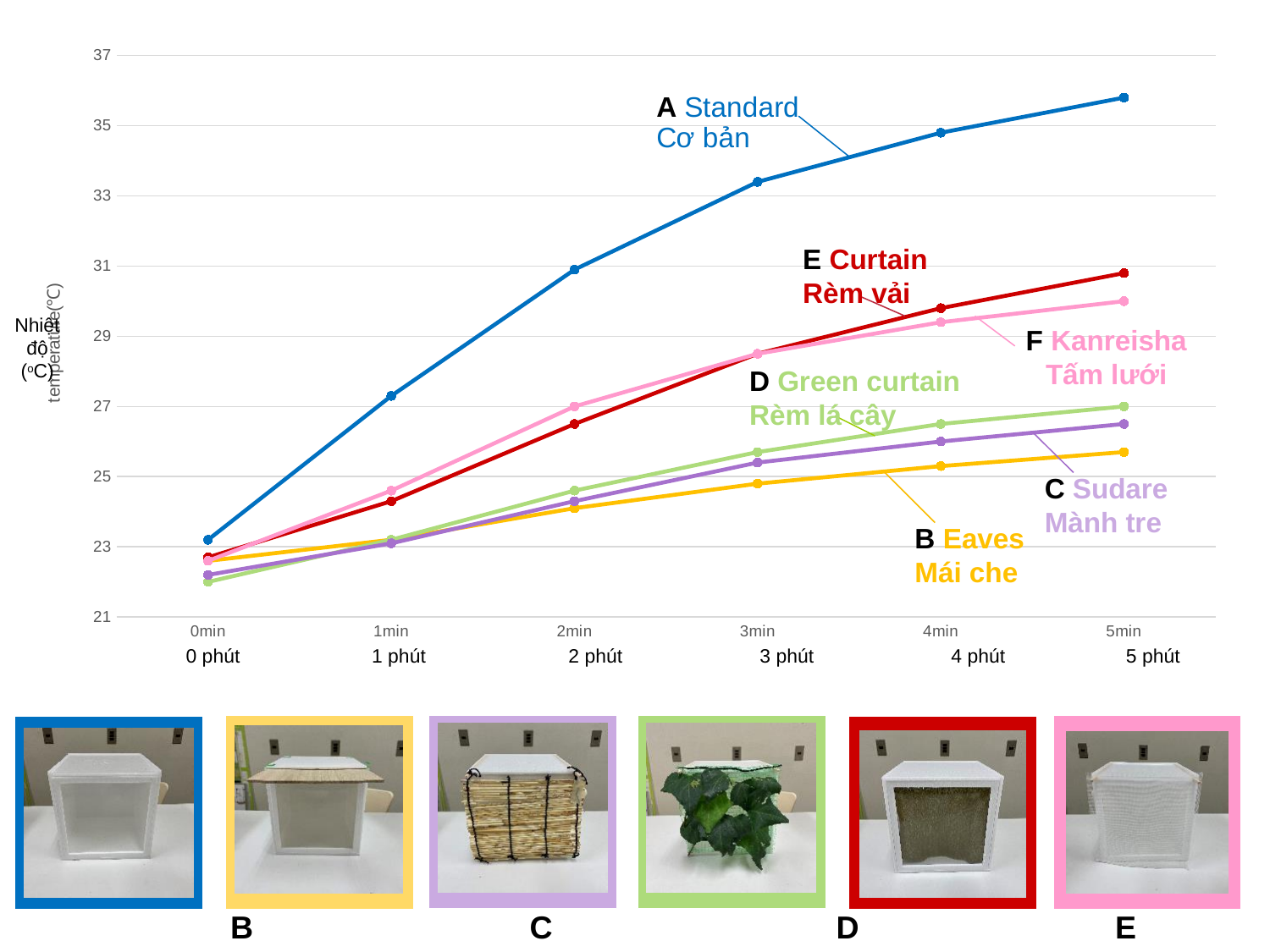
Which series has the lowest temperature at 5min? B Eaves Which series has the highest temperature at 5min? A Standard Does the A Standard line rise or fall from 0min to 5min? rise What kind of chart is shown on the slide? line chart How many time points are plotted along the x axis? 6 How many series (lines) are plotted on the chart? 6 Is the value for D Green curtain at 0min greater or less than 23? less At 4min, which is higher: A Standard or E Curtain? A Standard What colour is the line for A Standard? blue Is the value for E Curtain at 5min greater or less than 29? greater Is the value for A Standard at 5min greater or less than 35? greater